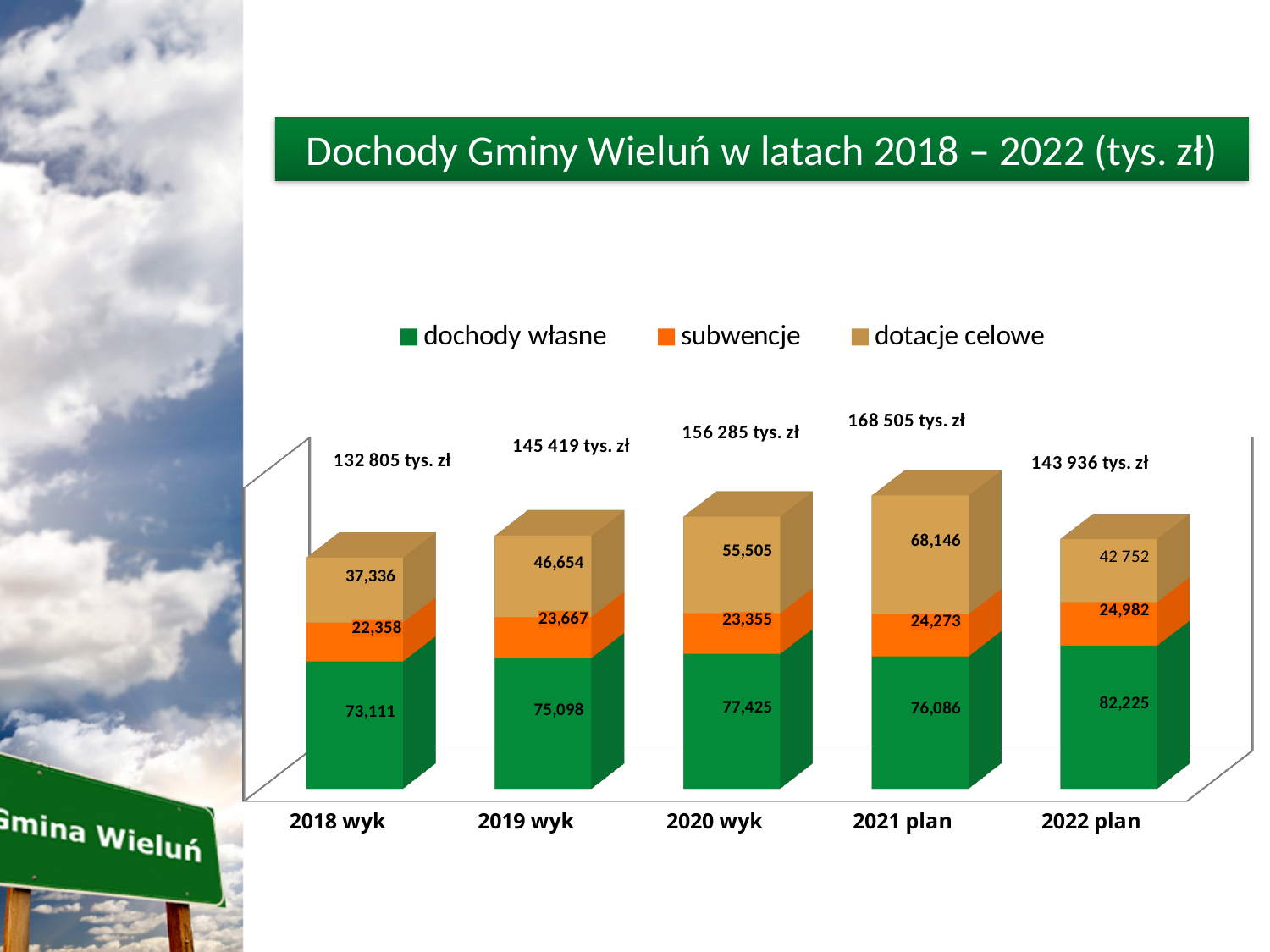
Is dotacje celowe larger in 2020 wyk or in 2022 plan? 2020 wyk Which year has the lowest total income? 2018 wyk What is the value of dotacje celowe for 2021 plan? 68,146 What is the value of dochody własne for 2022 plan? 82,225 What is the difference between dochody własne in 2022 plan and 2018 wyk? 9,114 Which year has the highest total income? 2021 plan What is the value of subwencje for 2018 wyk? 22,358 Which year has the highest value of dotacje celowe? 2021 plan What is the total printed above the bar for 2020 wyk? 156 285 tys. zł How many series does the legend list? 3 What kind of chart is shown on the slide? Stacked bar chart How many years (categories) are shown on the x axis? 5